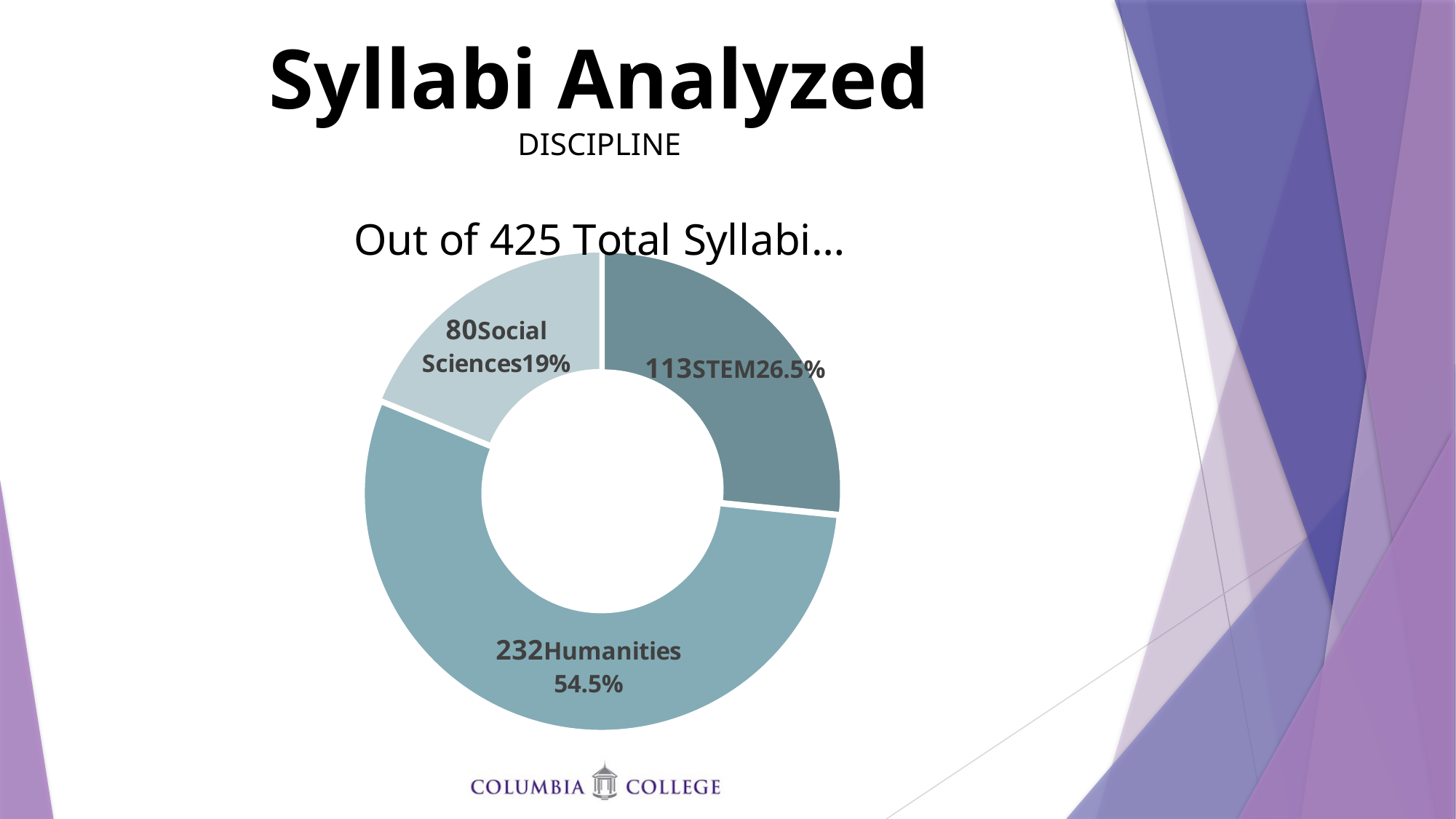
What percentage share does STEM have? 26.5% What kind of chart is shown on the slide? Doughnut (pie) chart How many syllabi are in the Humanities category? 232 How many syllabi are in the Social Sciences category? 80 Which category has the smallest number of syllabi? Social Sciences Which has more syllabi, STEM or Social Sciences? STEM What percentage share does Humanities have? 54.5% Which category has the largest number of syllabi? Humanities How many syllabi are in the STEM category? 113 What percentage share does Social Sciences have? 19% What is the difference between the number of Humanities syllabi and STEM syllabi? 119 How many categories does the chart show? 3